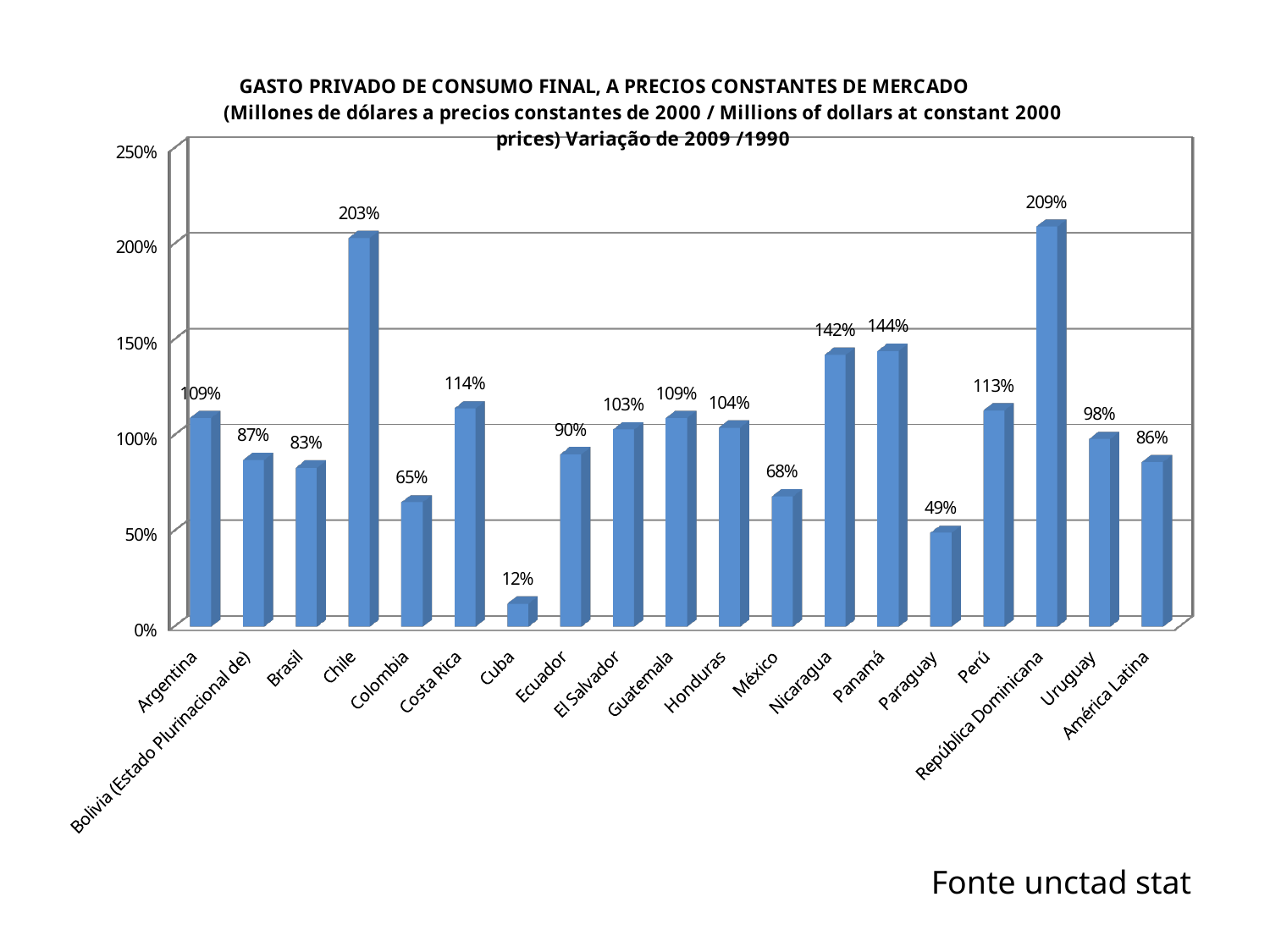
What is the value for América Latina? 86% What source is cited below the chart? Fonte unctad stat Which category has the lowest value? Cuba Which is larger, the value for Costa Rica or the value for Perú? Costa Rica Which category has the highest value? República Dominicana What is the difference between the values for República Dominicana and Chile? 6% What is the value for Chile? 203% What is the difference between the values for Panamá and Nicaragua? 2% Is the value for México greater or less than 100%? less How many categories are shown on the x axis? 19 What kind of chart is this? bar chart What is the value for Paraguay? 49%